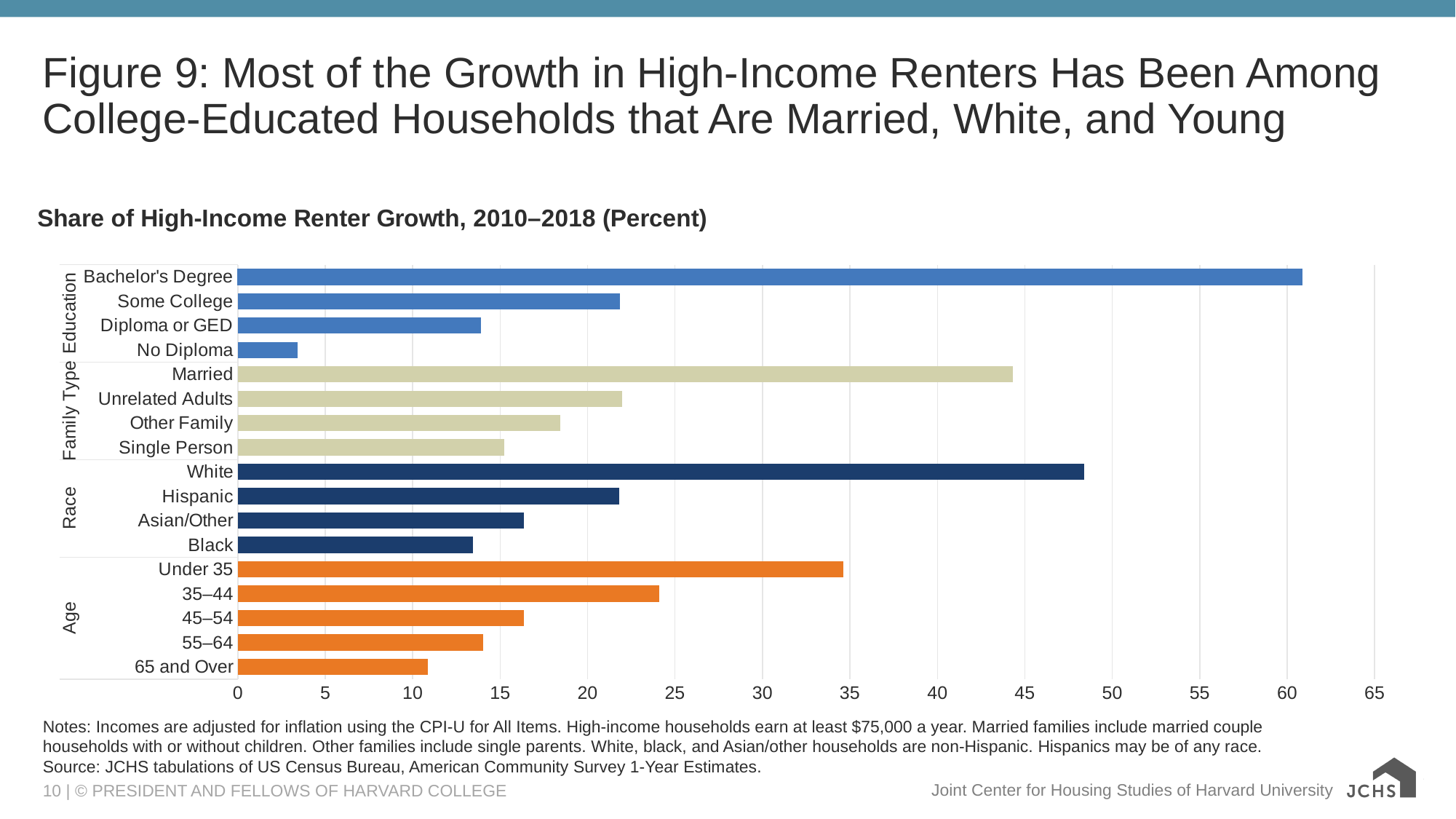
How many bars are plotted in the chart? 17 Is the value for 65 and Over greater or less than 15? less What is the title of the chart? Share of High-Income Renter Growth, 2010–2018 (Percent) Which category has the highest share of high-income renter growth? Bachelor's Degree Which category has the lowest share of high-income renter growth? No Diploma What kind of chart is shown on the slide? bar chart Is the value for Married greater or less than 40? greater Which is larger, the value for Hispanic or the value for Black? Hispanic Is the value for Under 35 greater or less than 30? greater Which is larger, the value for White or the value for Married? White